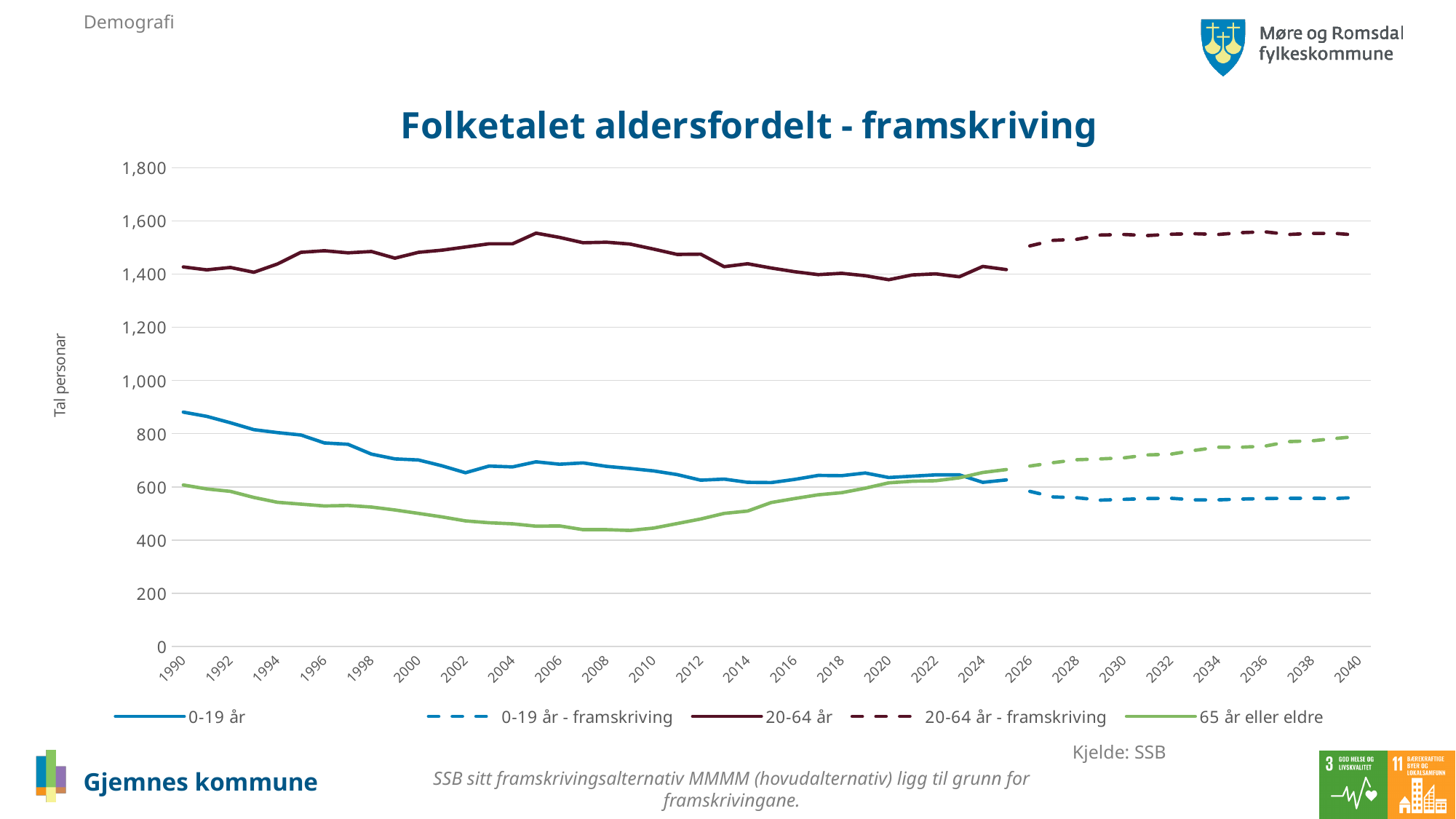
What is the title of the chart? Folketalet aldersfordelt - framskriving What is the label on the vertical axis? Tal personar Is the value for 0-19 år - framskriving in 2040 greater or less than 600? less Is the value for 65 år eller eldre in 2010 greater or less than 500? less Is the value for 20-64 år in 2006 greater or less than 1,500? greater In 1990, which is larger: the value for 0-19 år or the value for 65 år eller eldre? 0-19 år How many series does the legend list? 5 Which age group has the highest value in 1990? 20-64 år What kind of chart is shown on the slide? line chart Does the 0-19 år line rise or fall between 1990 and 2010? fall